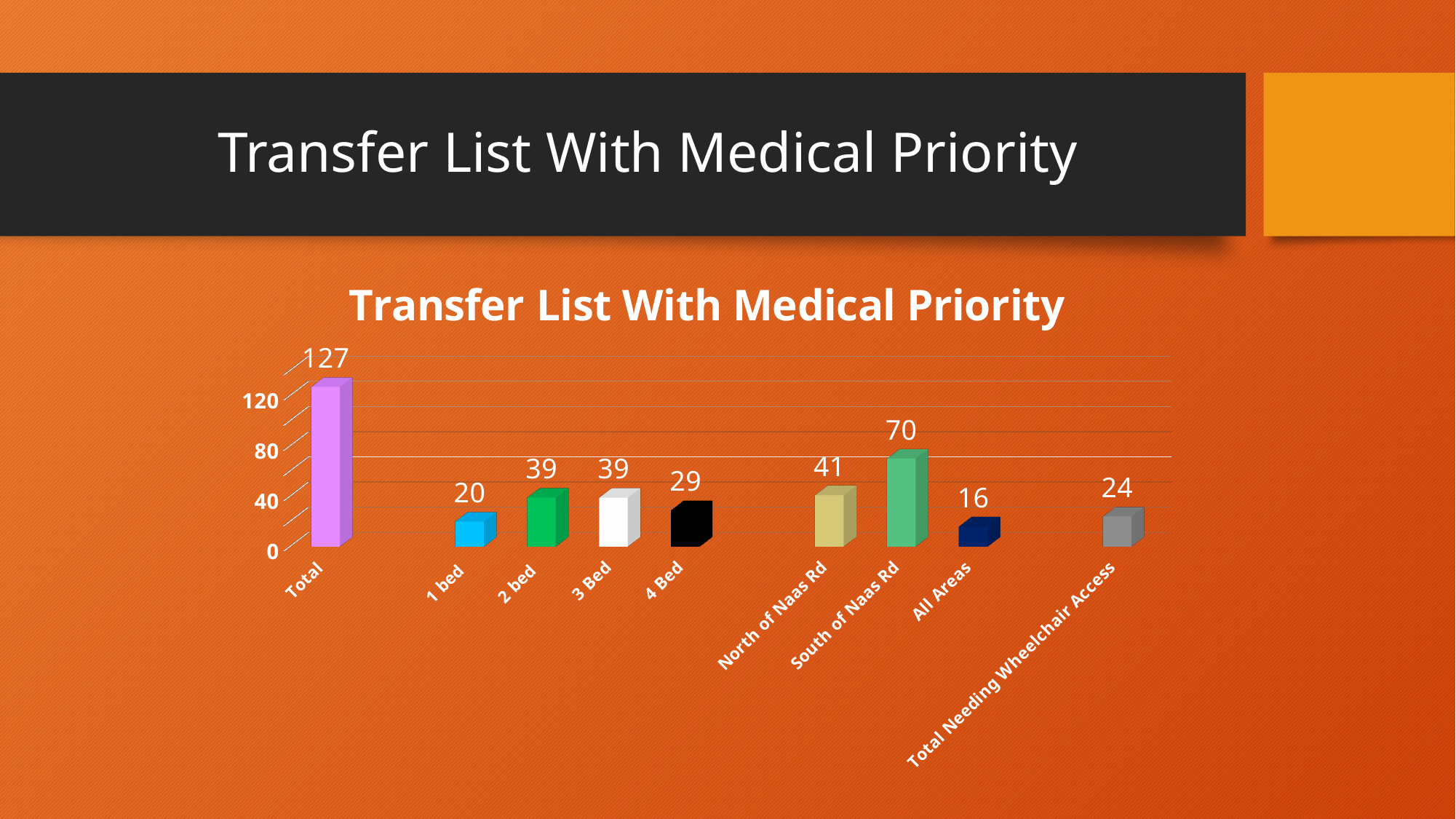
Which category has the highest value? Total What is the difference between the values for South of Naas Rd and North of Naas Rd? 29 How many categories are shown on the x axis? 9 What is the difference between the values for 2 bed and 1 bed? 19 What is the value for Total Needing Wheelchair Access? 24 What kind of chart is shown on the slide? Bar chart What is the title of the chart? Transfer List With Medical Priority Which is larger, the value for 1 bed or the value for 4 Bed? 4 Bed What is the value for 4 Bed? 29 Which category has the lowest value? All Areas What is the value for Total? 127 What is the value for South of Naas Rd? 70